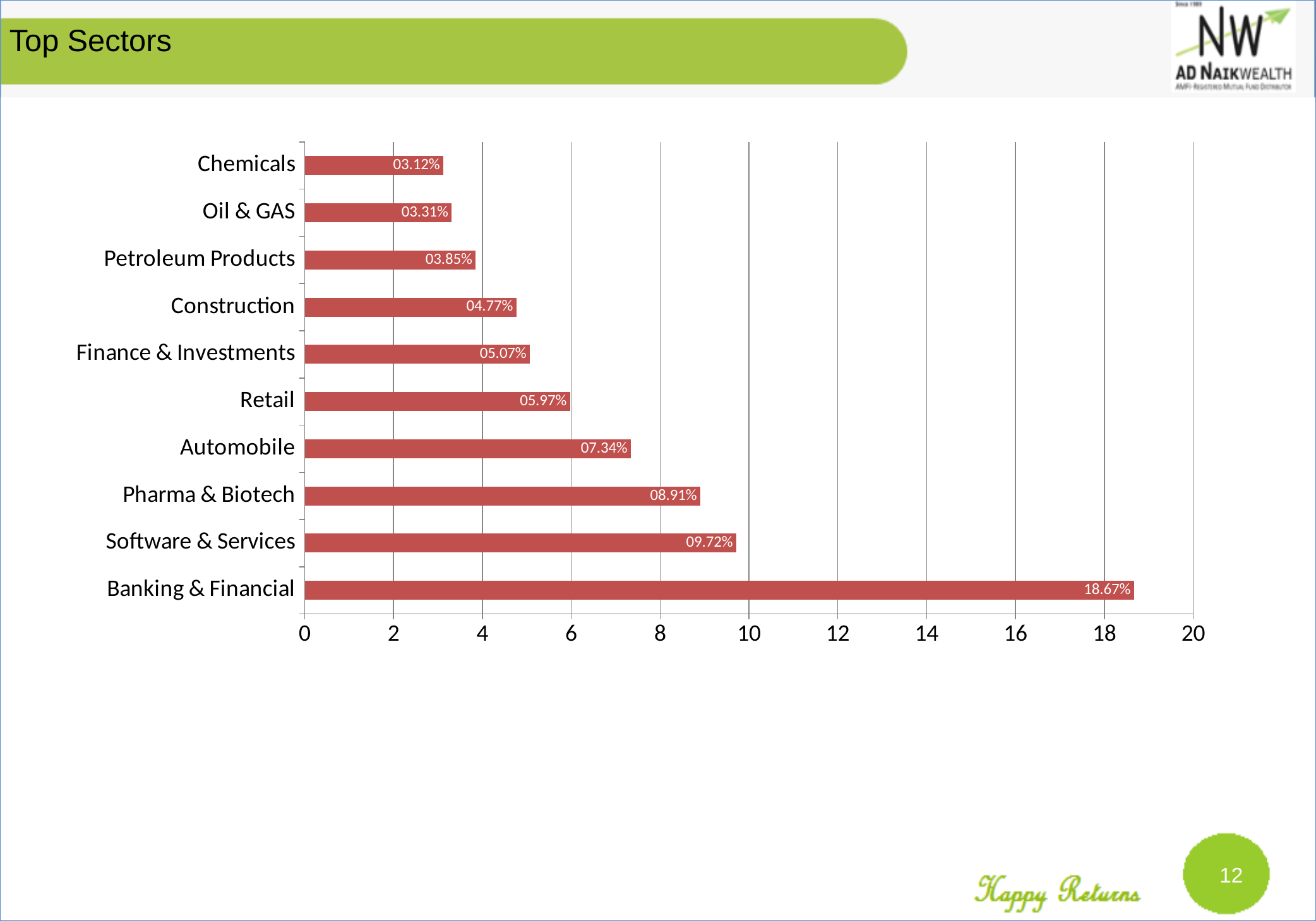
What kind of chart is shown on the slide? bar chart How many sectors are shown in the chart? 10 What is the difference between the values for Banking & Financial and Software & Services? 8.95% What is the title of the slide? Top Sectors What is the value for Petroleum Products? 03.85% What is the value for Retail? 05.97% Which sector has the lowest value? Chemicals Which is larger, the value for Pharma & Biotech or the value for Construction? Pharma & Biotech What is the difference between the values for Automobile and Retail? 1.37% Is the value for Finance & Investments greater or less than 4? greater What is the value for Banking & Financial? 18.67% Which sector has the highest value? Banking & Financial